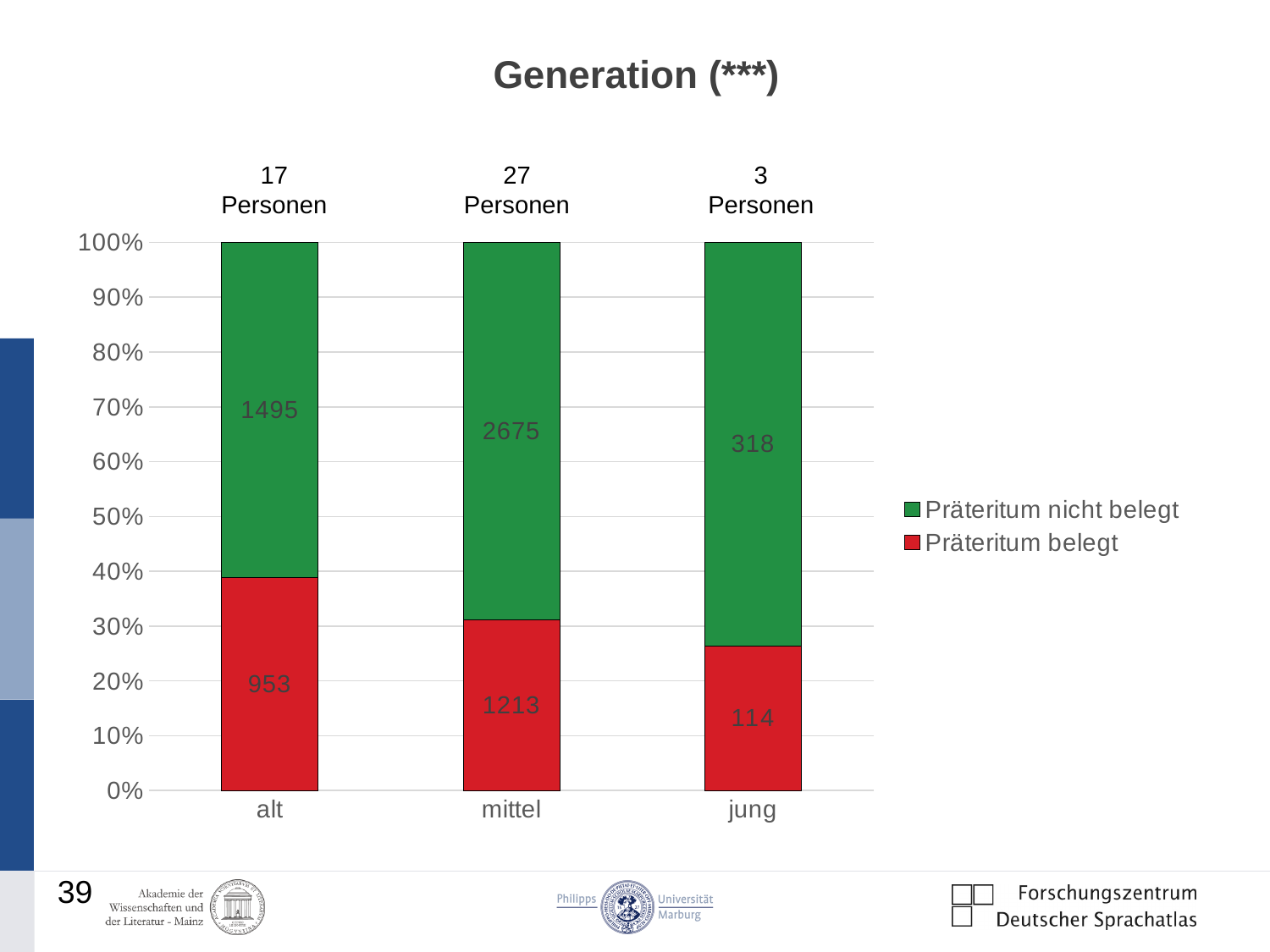
How many categories are shown on the x axis? 3 Which category has the lowest value for 'Präteritum belegt'? jung Is the share of 'Präteritum belegt' for 'alt' greater or less than 30%? greater How many series does the legend list? 2 Which category has the highest value for 'Präteritum nicht belegt'? mittel What is the value of 'Präteritum belegt' for the category 'alt'? 953 What is the value of 'Präteritum belegt' for the category 'jung'? 114 How many persons are indicated above the bar for 'mittel'? 27 Personen What is the value of 'Präteritum nicht belegt' for the category 'mittel'? 2675 What is the total of the two values in the bar for 'jung'? 432 What is the difference between 'Präteritum nicht belegt' and 'Präteritum belegt' for the category 'alt'? 542 What type of chart is shown on the slide? stacked bar chart